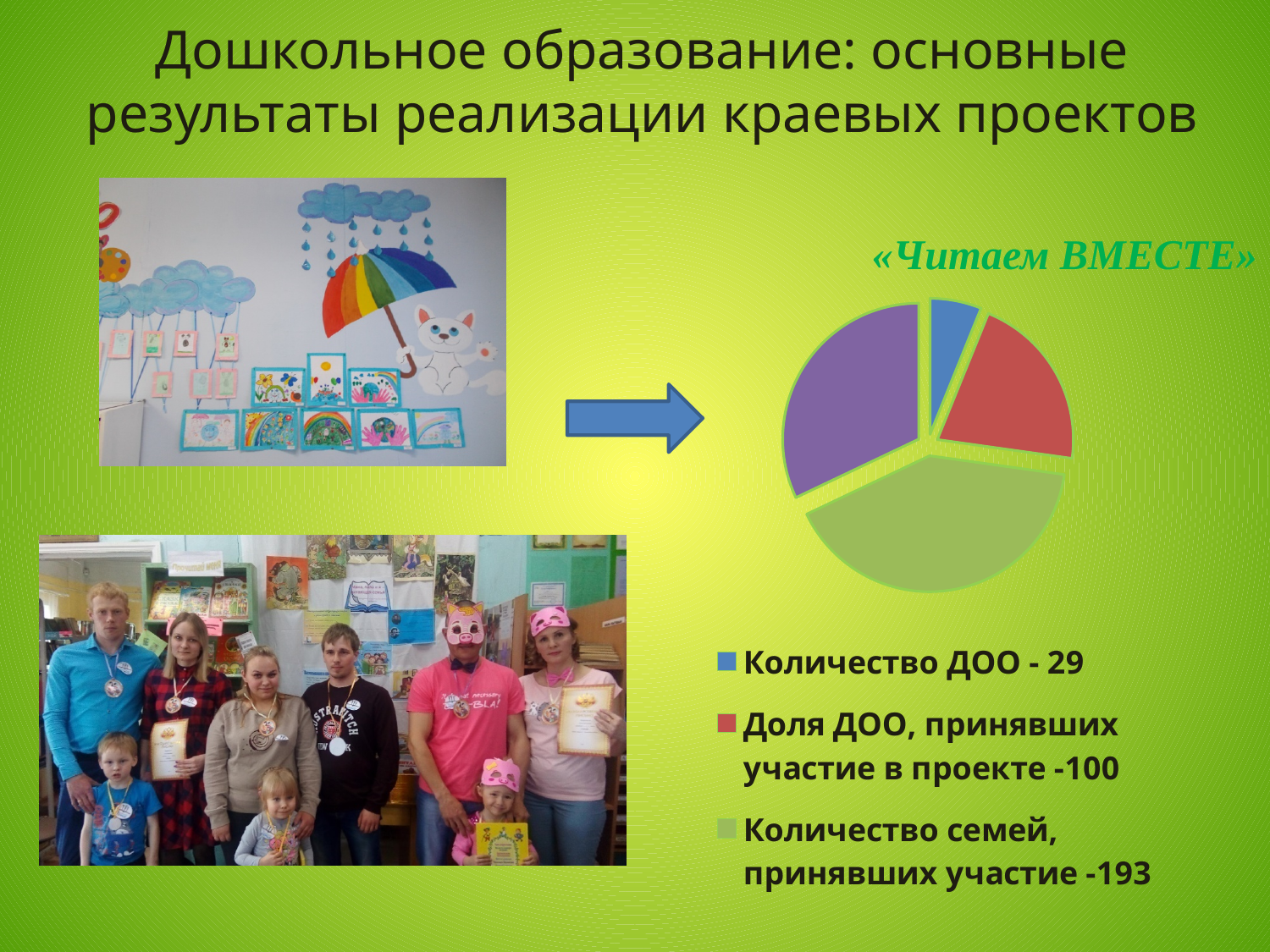
What colour is the slice for «Количество семей, принявших участие»? green Which legend category has the smallest value? Количество ДОО What is the difference between the number of families that took part (193) and the number of ДОО (29)? 164 What is the value given for «Доля ДОО, принявших участие в проекте»? 100 Which legend category has the largest value? Количество семей, принявших участие How many slices does the pie chart have? 4 Which is larger: «Доля ДОО, принявших участие в проекте» or «Количество ДОО»? Доля ДОО, принявших участие в проекте What is the title of the pie chart? «Читаем ВМЕСТЕ» How many entries does the legend of the pie chart list? 3 What is the value given for «Количество ДОО» in the legend? 29 What is the value given for «Количество семей, принявших участие»? 193 What kind of chart is shown on the slide? pie chart